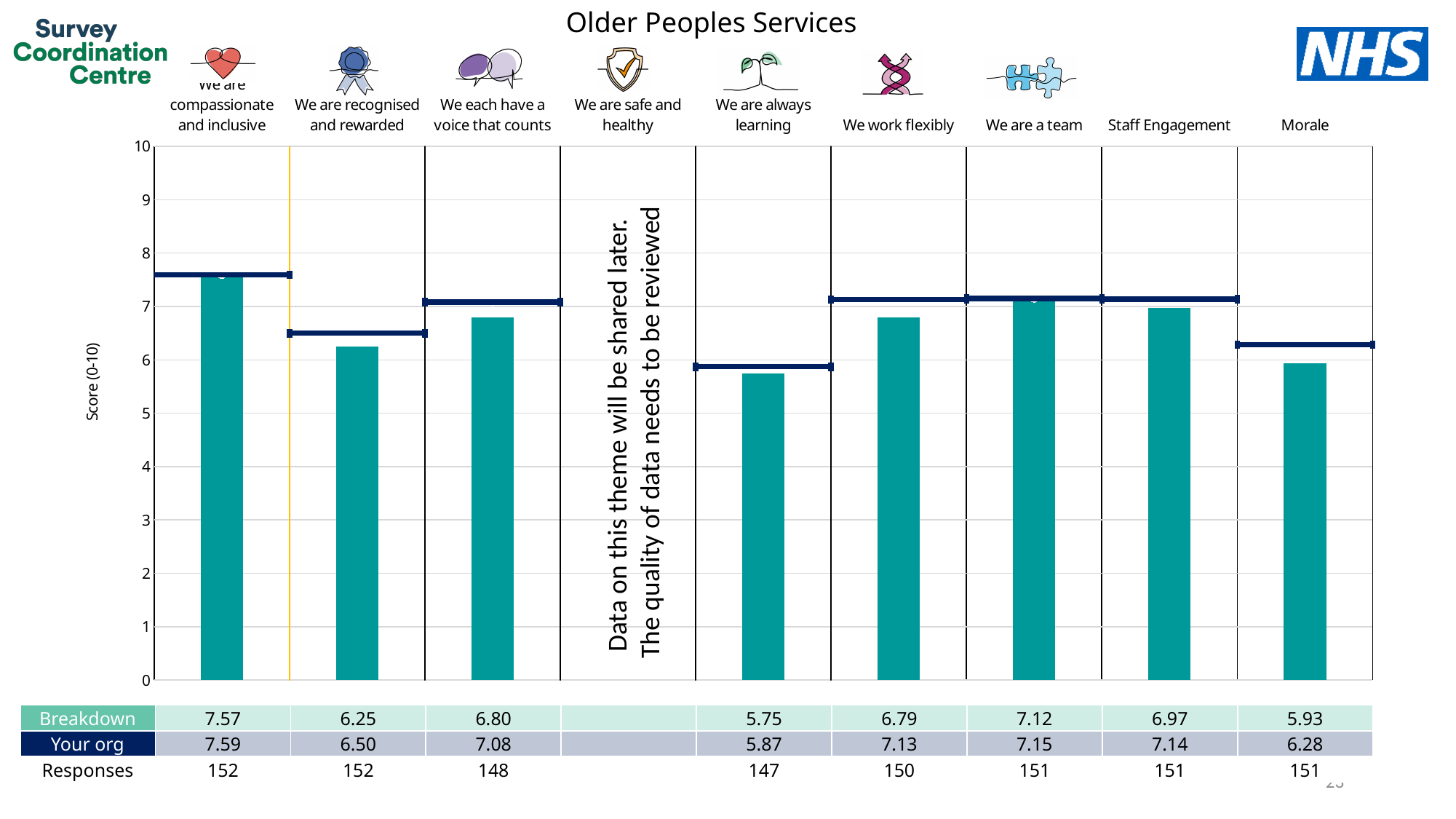
What is the Your org score for 'Morale'? 6.28 What is the difference between the Your org score and the Breakdown score for 'Morale'? 0.35 Which theme has the lowest Breakdown score? We are always learning Which theme has the highest Breakdown score? We are compassionate and inclusive What is the Breakdown score for 'We are always learning'? 5.75 Which is larger, the Breakdown score for 'We each have a voice that counts' or for 'Staff Engagement'? Staff Engagement What is the difference between the Breakdown scores for 'We are a team' and 'We are recognised and rewarded'? 0.87 How many responses were recorded for 'We each have a voice that counts'? 148 Is the Breakdown score for 'We work flexibly' greater or less than 7? less What is the title of the chart? Older Peoples Services What type of chart is shown on the slide? bar chart What is the Breakdown score for 'We are compassionate and inclusive'? 7.57